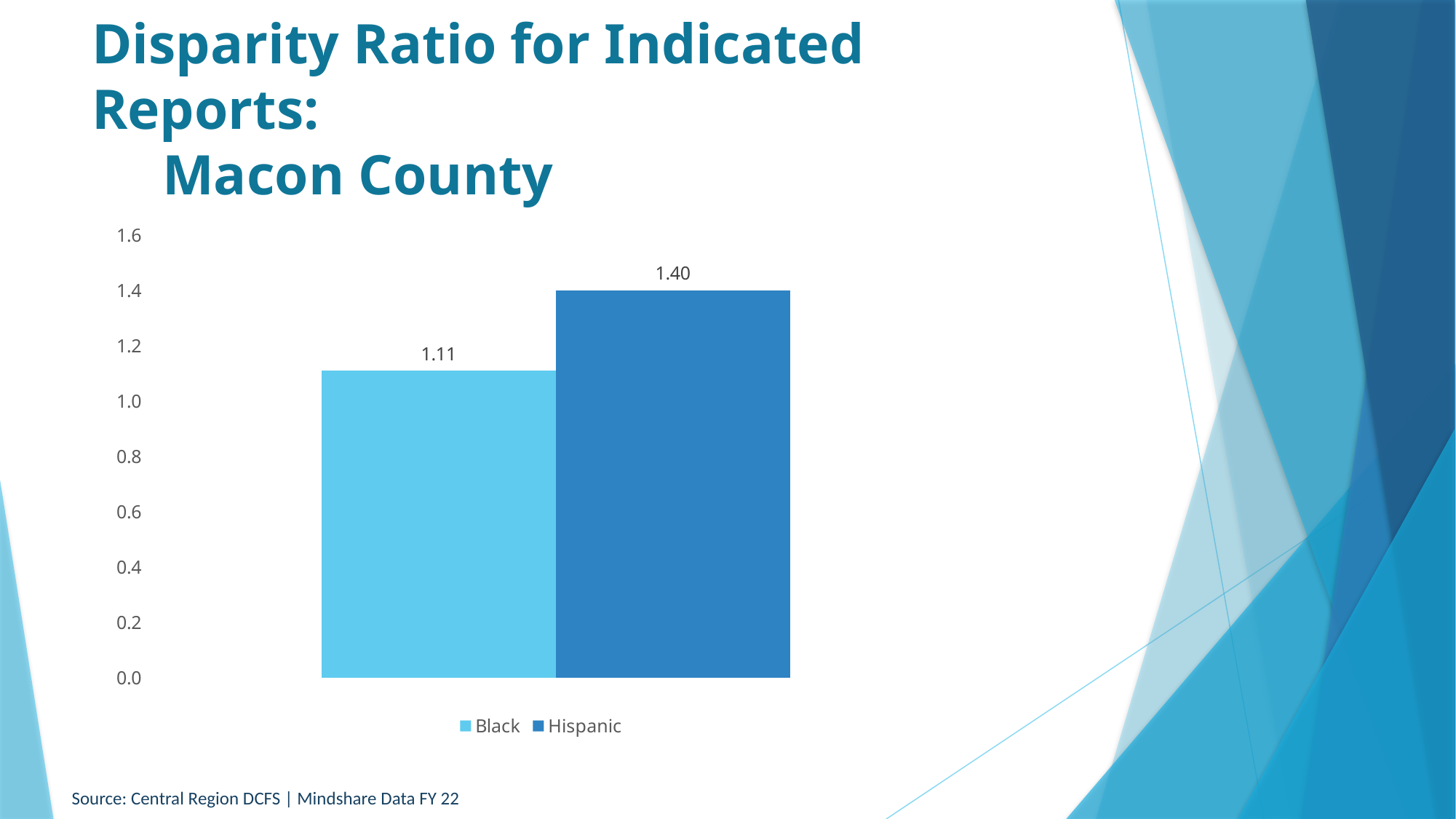
What kind of chart is shown on the slide? Bar chart What is the difference between the Hispanic and Black disparity ratios? 0.29 What is the disparity ratio for Black in the chart? 1.11 Which group has the higher disparity ratio? Hispanic Is the disparity ratio for Black greater or less than 1.0? greater How many series does the legend list? 2 What is the maximum value shown on the vertical axis? 1.6 Which group has the lower disparity ratio? Black Is the disparity ratio for Hispanic greater or less than 1.6? less What is the disparity ratio for Hispanic in the chart? 1.40 Which county does the chart title refer to? Macon County